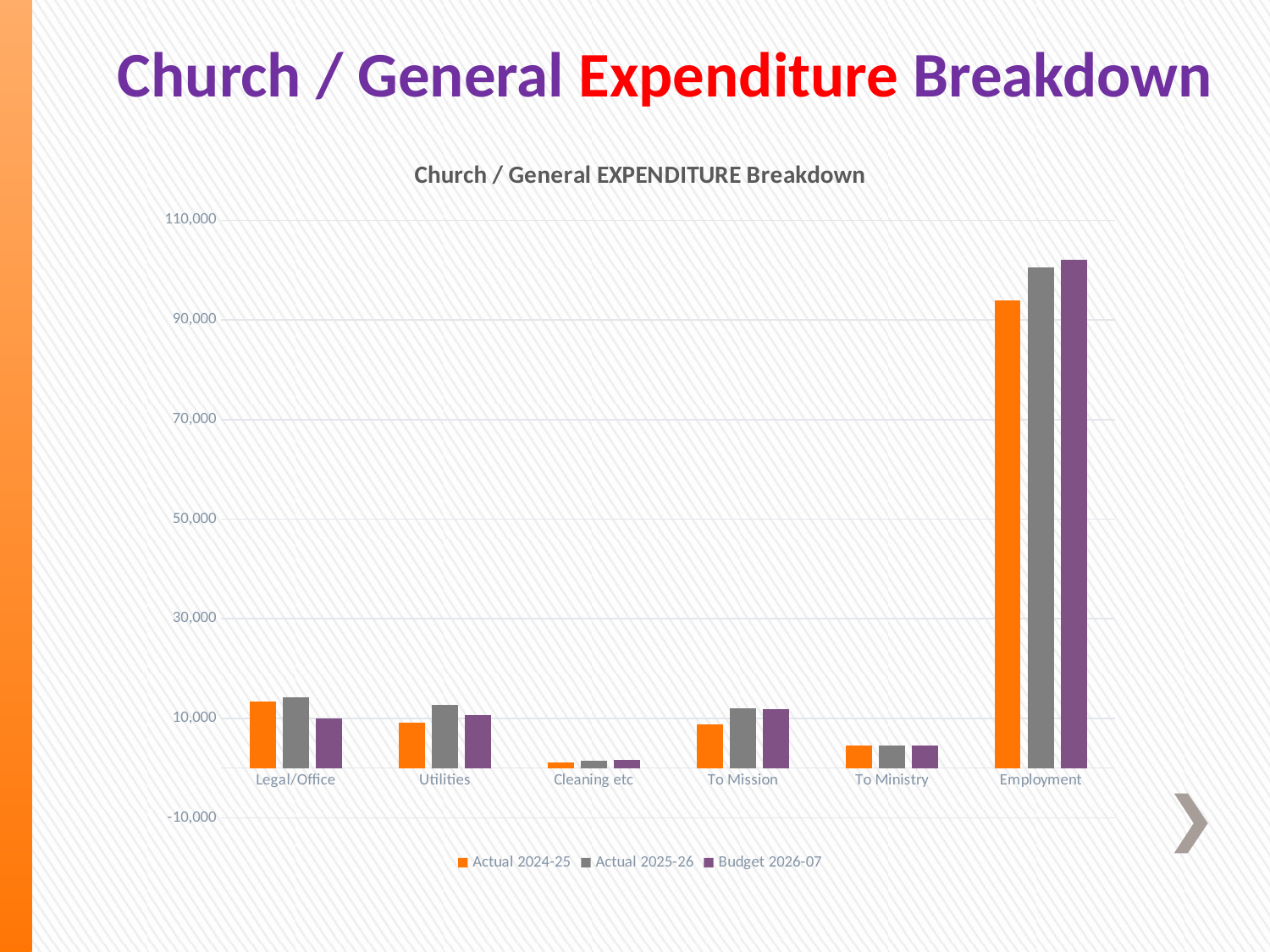
Which series is shown in orange? Actual 2024-25 Is the Actual 2025-26 value for Utilities greater or less than 10,000? greater How many series does the legend list? 3 Is the Budget 2026-07 value for To Ministry greater or less than 10,000? less Is the Budget 2026-07 value for Employment greater or less than 110,000? less What kind of chart is shown on the slide? Bar chart For Employment, which is larger: Actual 2024-25 or Actual 2025-26? Actual 2025-26 Which category has the highest expenditure for Actual 2025-26? Employment What is the title of the chart? Church / General EXPENDITURE Breakdown Which category has the lowest expenditure for Actual 2024-25? Cleaning etc How many expenditure categories are shown on the x axis? 6